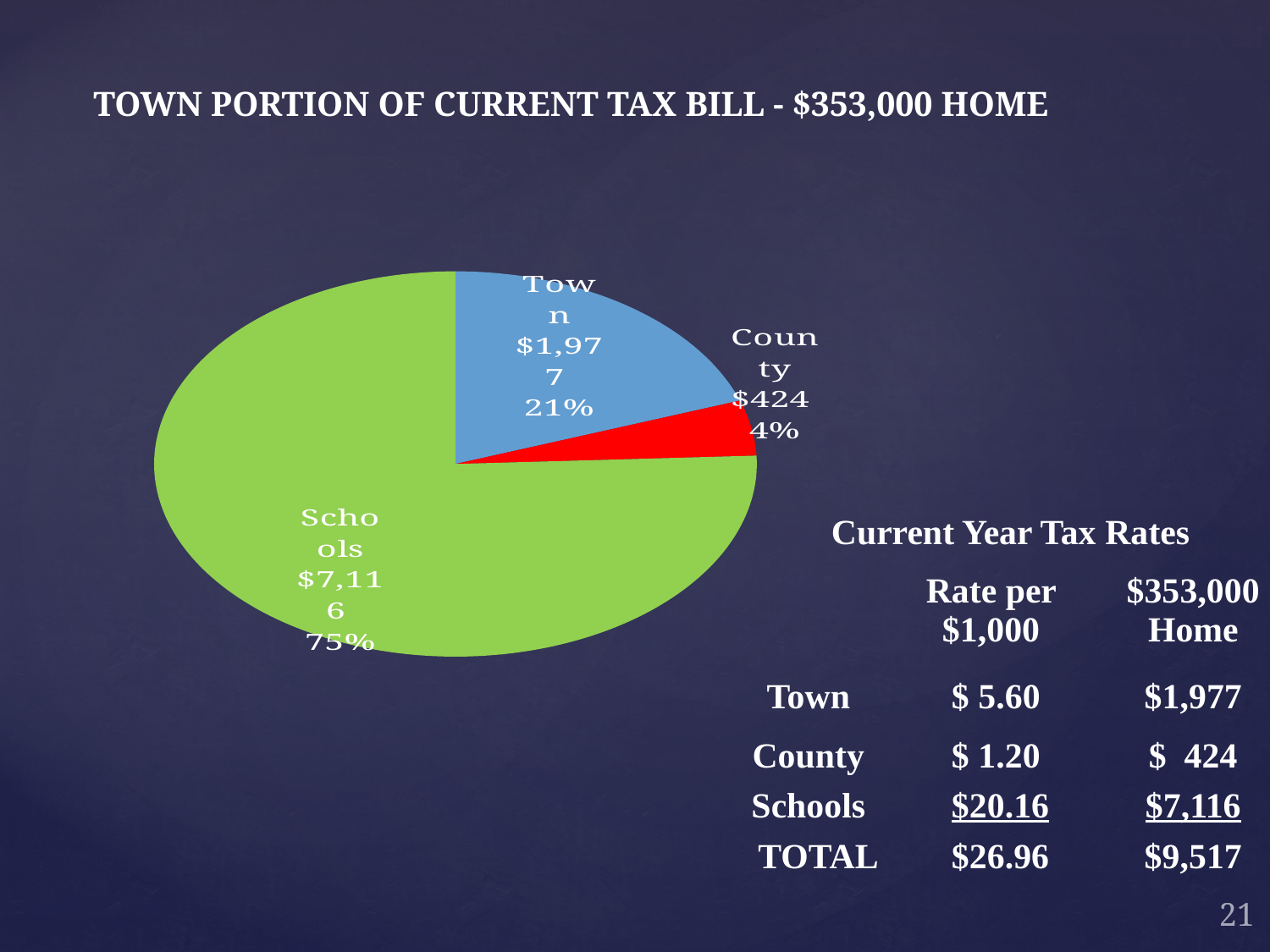
What percentage share of the pie does the Town slice represent? 21% Which slice of the pie chart is the smallest? County What dollar amount is shown for the Schools slice of the pie chart? $7,116 What kind of chart is shown on the slide? pie chart Which slice of the pie chart is the largest? Schools How many slices does the pie chart have? 3 What percentage share of the pie does the Schools slice represent? 75% What dollar amount is shown for the County slice of the pie chart? $424 What percentage share of the pie does the County slice represent? 4% What colour is the Schools slice of the pie chart? green What dollar amount is shown for the Town slice of the pie chart? $1,977 What is the difference in dollars between the Town slice and the County slice? $1,553